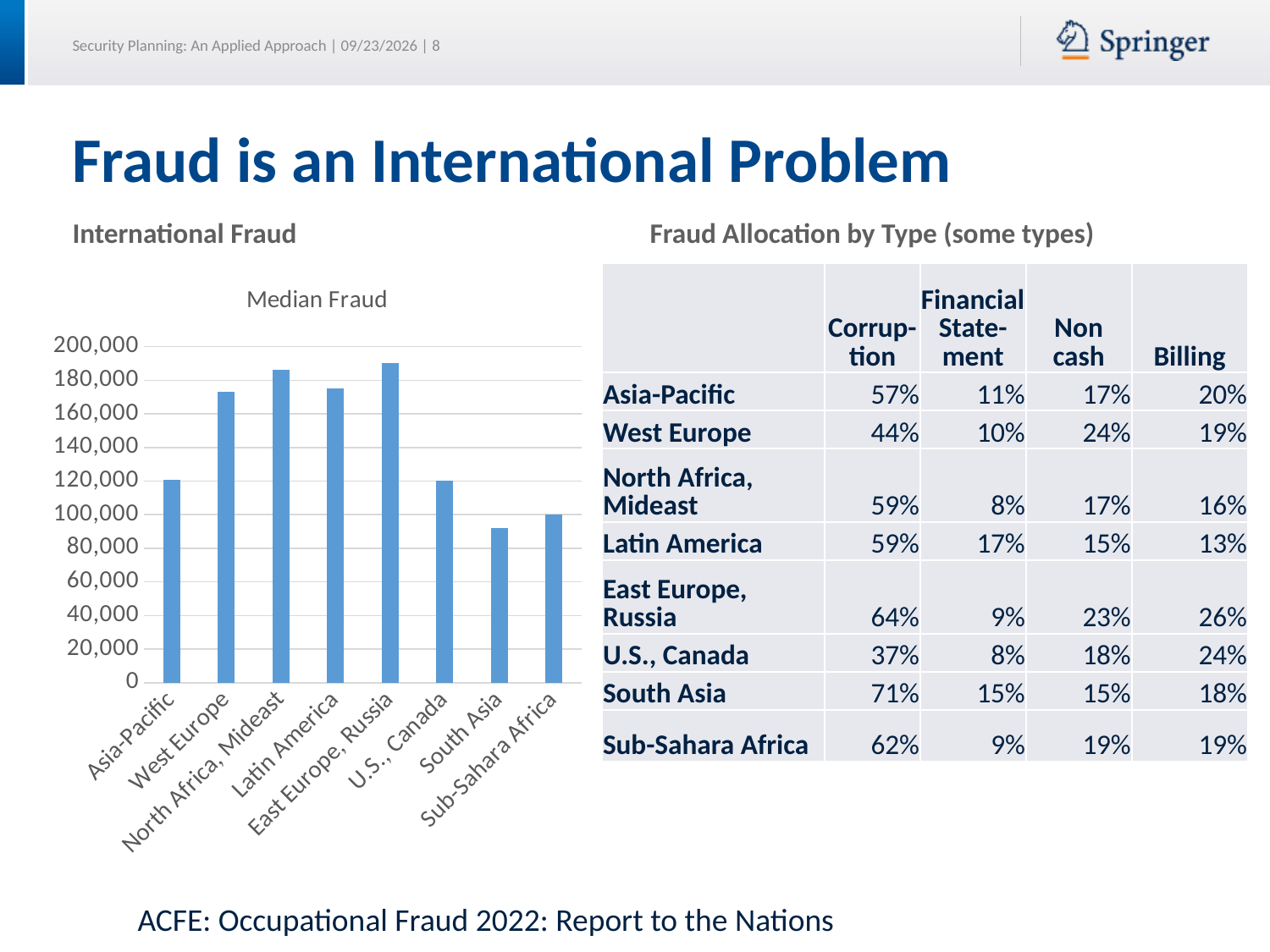
Is the median fraud value for North Africa, Mideast greater or less than 180,000? greater Is the median fraud value for U.S., Canada greater or less than 140,000? less Which has a higher median fraud value, Latin America or U.S., Canada? Latin America Which has a higher median fraud value, West Europe or Asia-Pacific? West Europe What is the highest value shown on the y axis of the Median Fraud chart? 200,000 What kind of chart is the Median Fraud chart? bar chart Is the median fraud value for East Europe, Russia greater or less than 180,000? greater How many regions are shown on the x axis of the Median Fraud chart? 8 Which region has the lowest median fraud in the chart? South Asia What is the title of the chart on the slide? Median Fraud